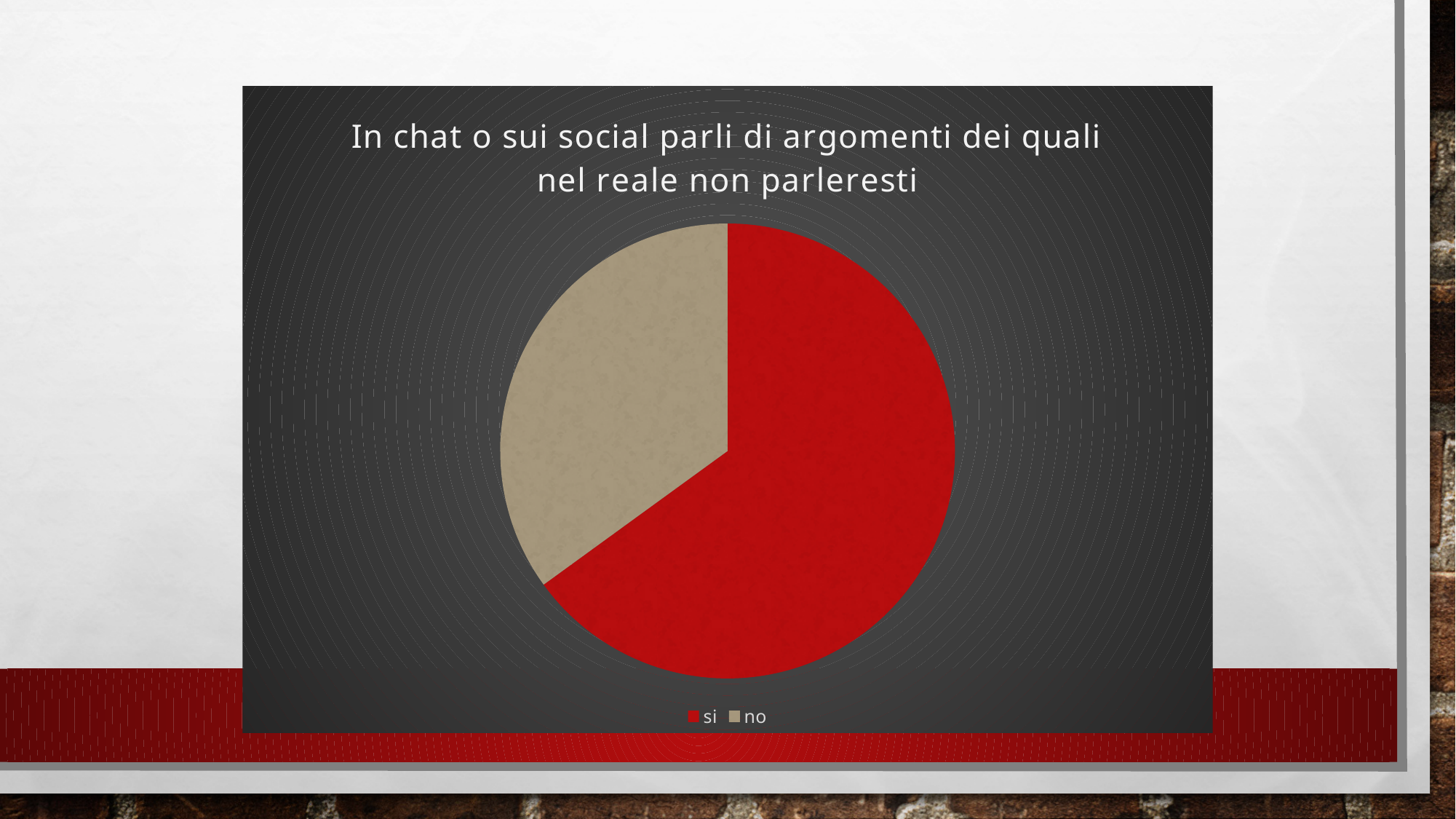
Which slice is the largest in the pie chart? si Which slice is the smallest in the pie chart? no What kind of chart is shown on the slide? pie chart Which legend entry is shown in beige/tan? no Which slice is larger, "si" or "no"? si What is the title of the chart? In chat o sui social parli di argomenti dei quali nel reale non parleresti What colour is the "si" slice? red How many slices does the pie chart have? 2 How many entries does the legend list? 2